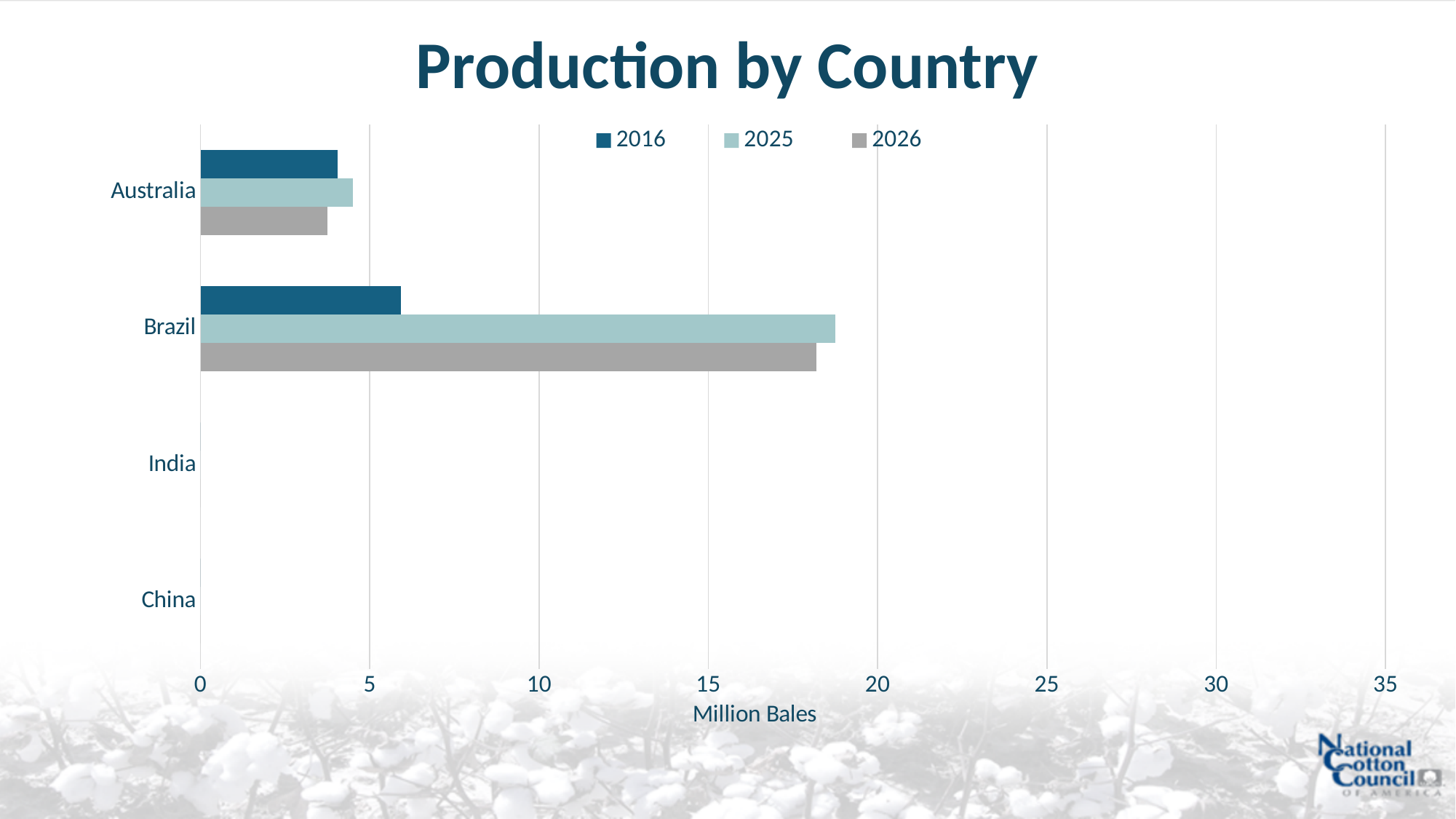
Is the 2025 value for Australia greater or less than 5? less How many series does the legend list? 3 What is the label on the horizontal axis? Million Bales Which country has the highest 2025 value? Brazil Is the 2016 value for Brazil greater or less than 10? less Which is larger for Brazil, the 2016 value or the 2025 value? 2025 How many countries are listed on the vertical axis? 4 Which is larger for Australia, the 2025 value or the 2026 value? 2025 Is the 2025 value for Brazil greater or less than 15? greater What kind of chart is shown on the slide? bar chart What is the title of the chart? Production by Country